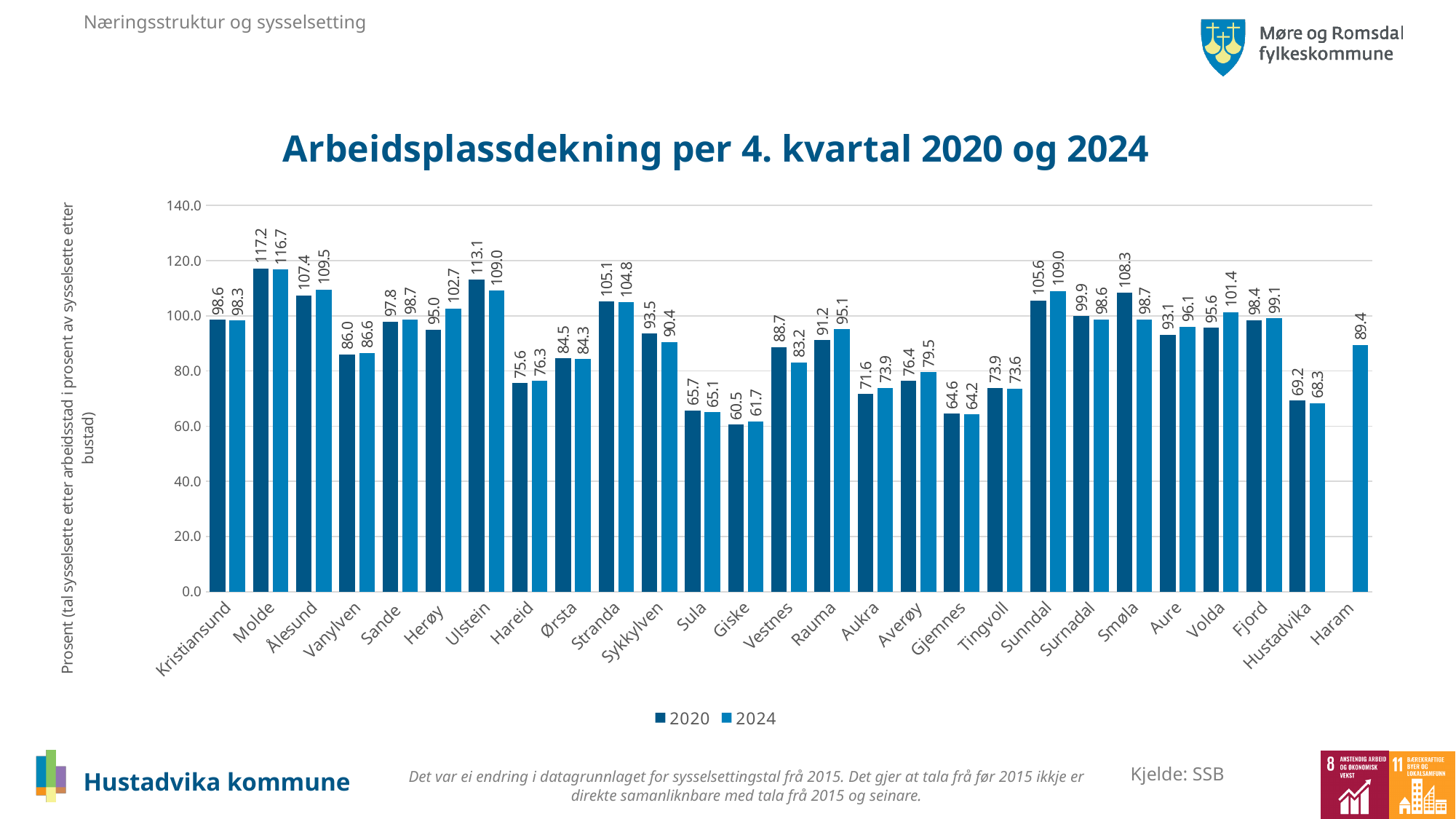
What is the 2024 value for Herøy? 102.7 How many series does the legend list? 2 What is the 2020 value for Hustadvika? 69.2 Which municipality has the lowest 2024 value? Giske What kind of chart is shown on the slide? Bar chart Which is larger for Ulstein: the 2020 value or the 2024 value? 2020 How many municipalities are shown on the x axis? 27 What is the difference between the 2020 and 2024 values for Smøla? 9.6 Which is larger for Volda: the 2020 value or the 2024 value? 2024 Which municipality has the highest 2020 value? Molde What is the 2024 value for Haram? 89.4 What is the difference between the 2024 and 2020 values for Herøy? 7.7